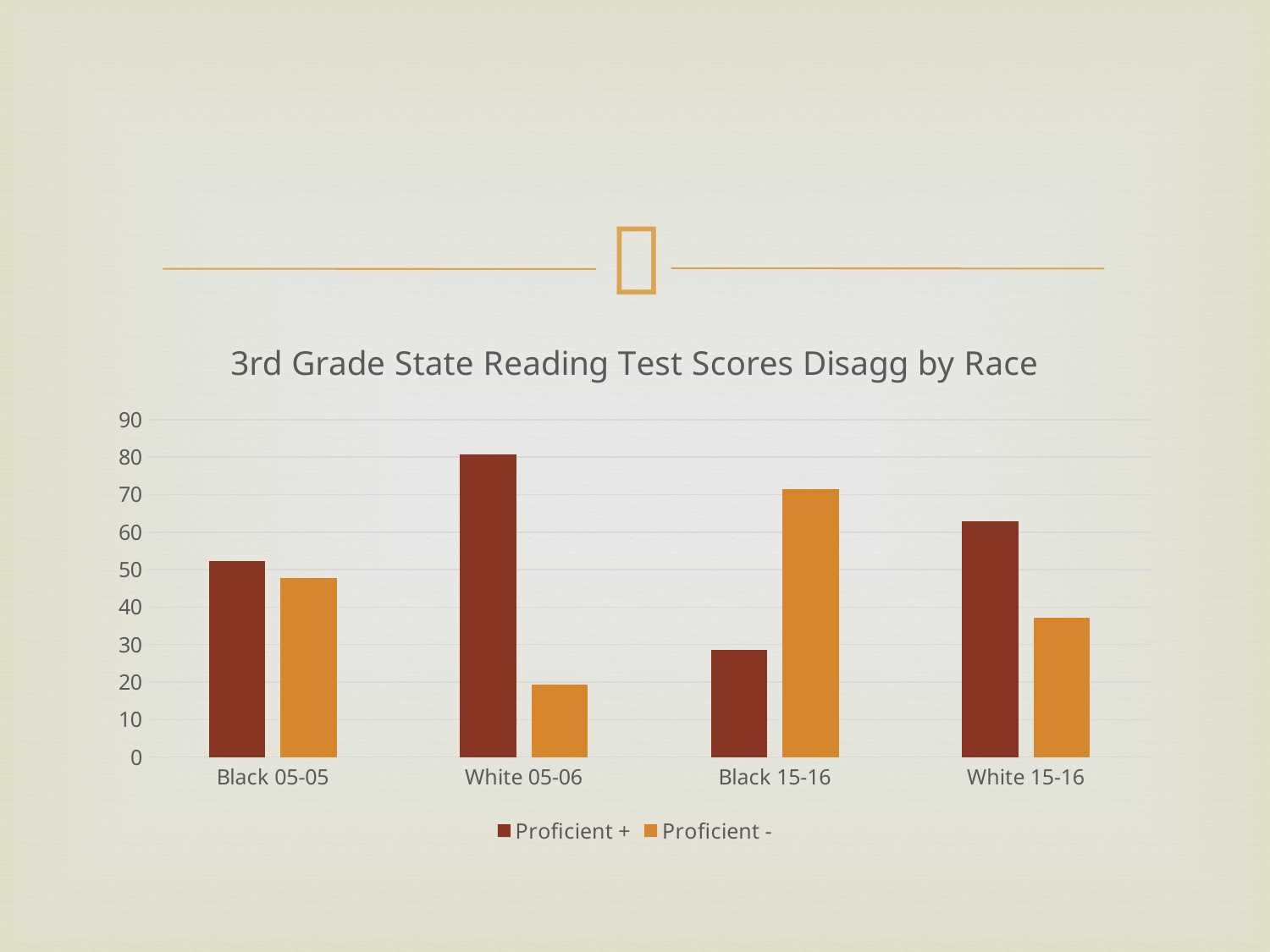
Which category has the lowest Proficient + value? Black 15-16 What kind of chart is shown on the slide? bar chart What is the title of the chart? 3rd Grade State Reading Test Scores Disagg by Race Which category has the highest Proficient - value? Black 15-16 How many categories are shown on the x axis? 4 How many series does the legend list? 2 Is the Proficient + value for Black 15-16 greater or less than 30? less For White 15-16, which is larger, Proficient + or Proficient -? Proficient + Which category has the highest Proficient + value? White 05-06 Which category has the lowest Proficient - value? White 05-06